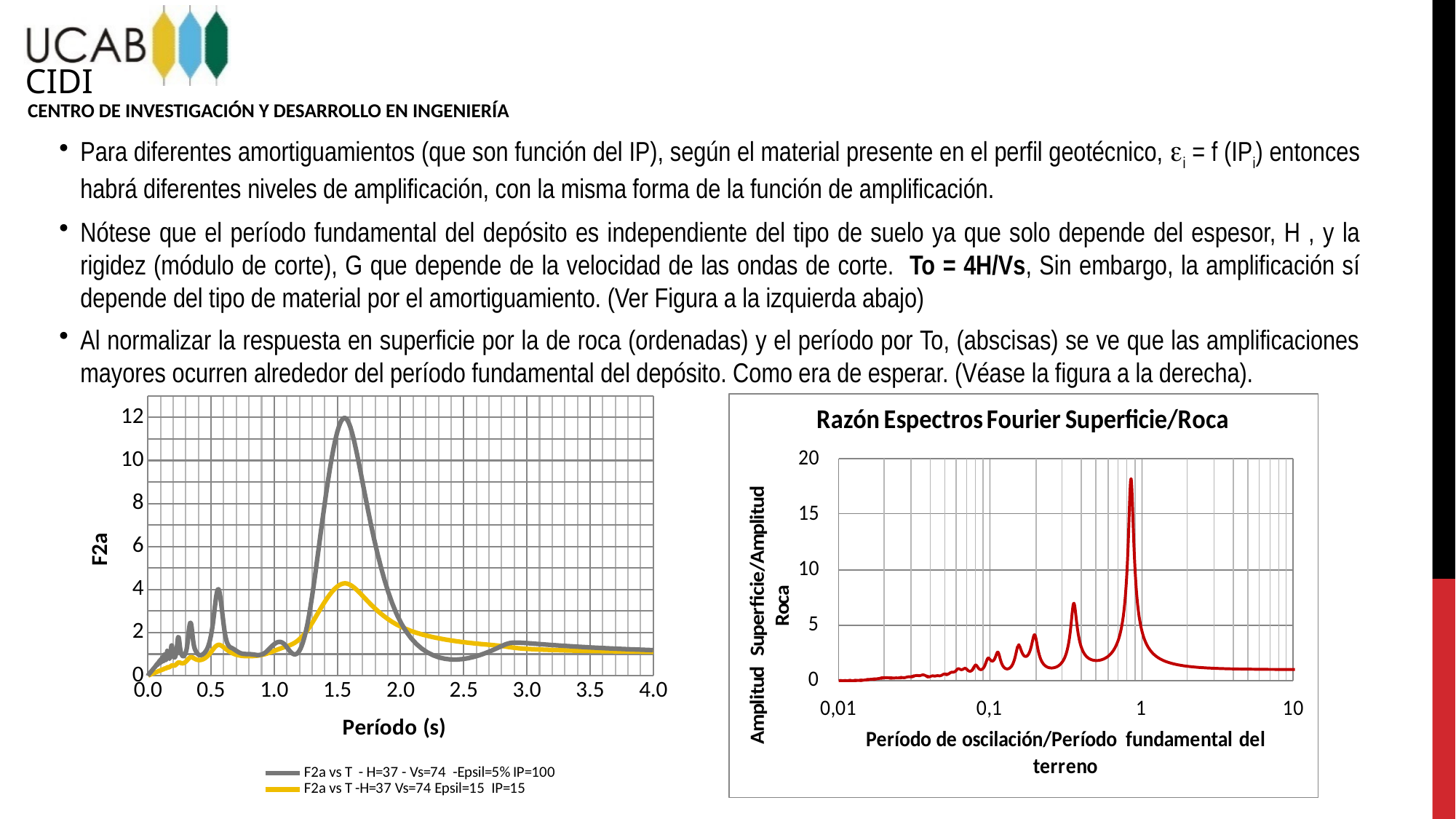
In the right chart (Razón Espectros Fourier Superficie/Roca), do the values rise or fall between a period ratio of 1 and 10? fall What is the x-axis label of the right chart? Período de oscilación/Período fundamental del terreno What is the title of the right chart? Razón Espectros Fourier Superficie/Roca In the right chart (Razón Espectros Fourier Superficie/Roca), is the maximum value of the curve greater or less than 15? greater In the left chart (F2a vs Período), is the peak value of the yellow series (Epsil=15 IP=15) greater or less than 6? less How many series does the legend of the left chart (F2a vs Período) list? 2 In the left chart (F2a vs Período), is the peak value of the grey series (Epsil=5% IP=100) greater or less than 10? greater What kind of chart is the right chart titled 'Razón Espectros Fourier Superficie/Roca'? line chart In the left chart (F2a vs Período), do the values of the grey series rise or fall between periods 1.5 s and 2.5 s? fall In the left chart (F2a vs Período), which series reaches the higher peak: the grey series (Epsil=5% IP=100) or the yellow series (Epsil=15 IP=15)? the grey series (Epsil=5% IP=100) What kind of chart is the left chart (F2a vs Período)? line chart